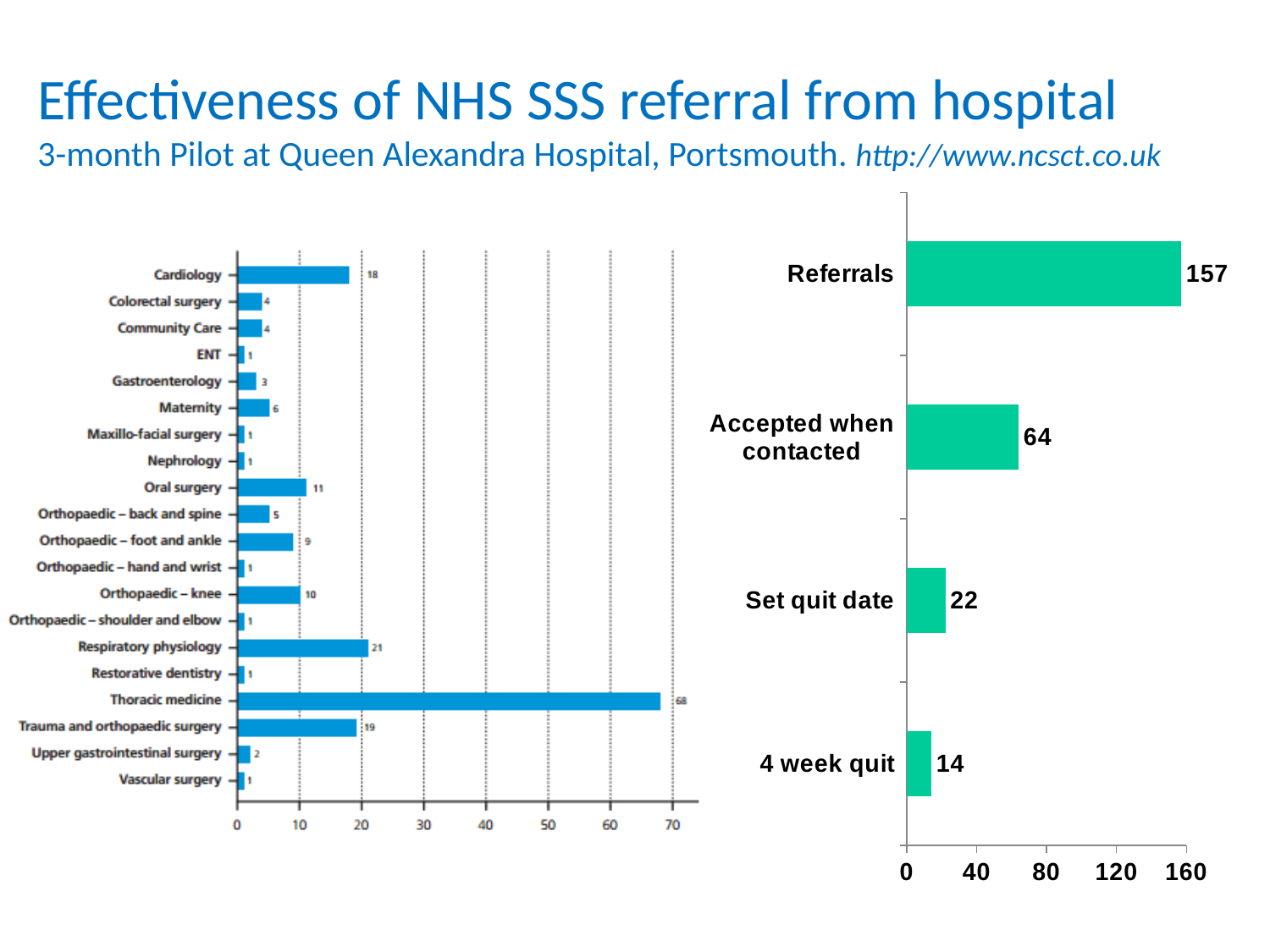
On the right-hand chart, which category has the lowest value? 4 week quit On the left-hand chart, what is the value for Thoracic medicine? 68 On the left-hand chart, which is larger, Cardiology or Oral surgery? Cardiology On the left-hand chart, which department has the highest value? Thoracic medicine On the right-hand chart, how many categories are shown? 4 On the right-hand chart, what is the difference between Referrals and Set quit date? 135 On the right-hand chart, what is the value for Accepted when contacted? 64 On the left-hand chart, what is the difference between Trauma and orthopaedic surgery and Orthopaedic – knee? 9 What kind of chart is the left-hand chart? Bar chart On the right-hand chart, what is the value for 4 week quit? 14 On the left-hand chart, what is the value for Respiratory physiology? 21 On the right-hand chart, what is the value for Referrals? 157